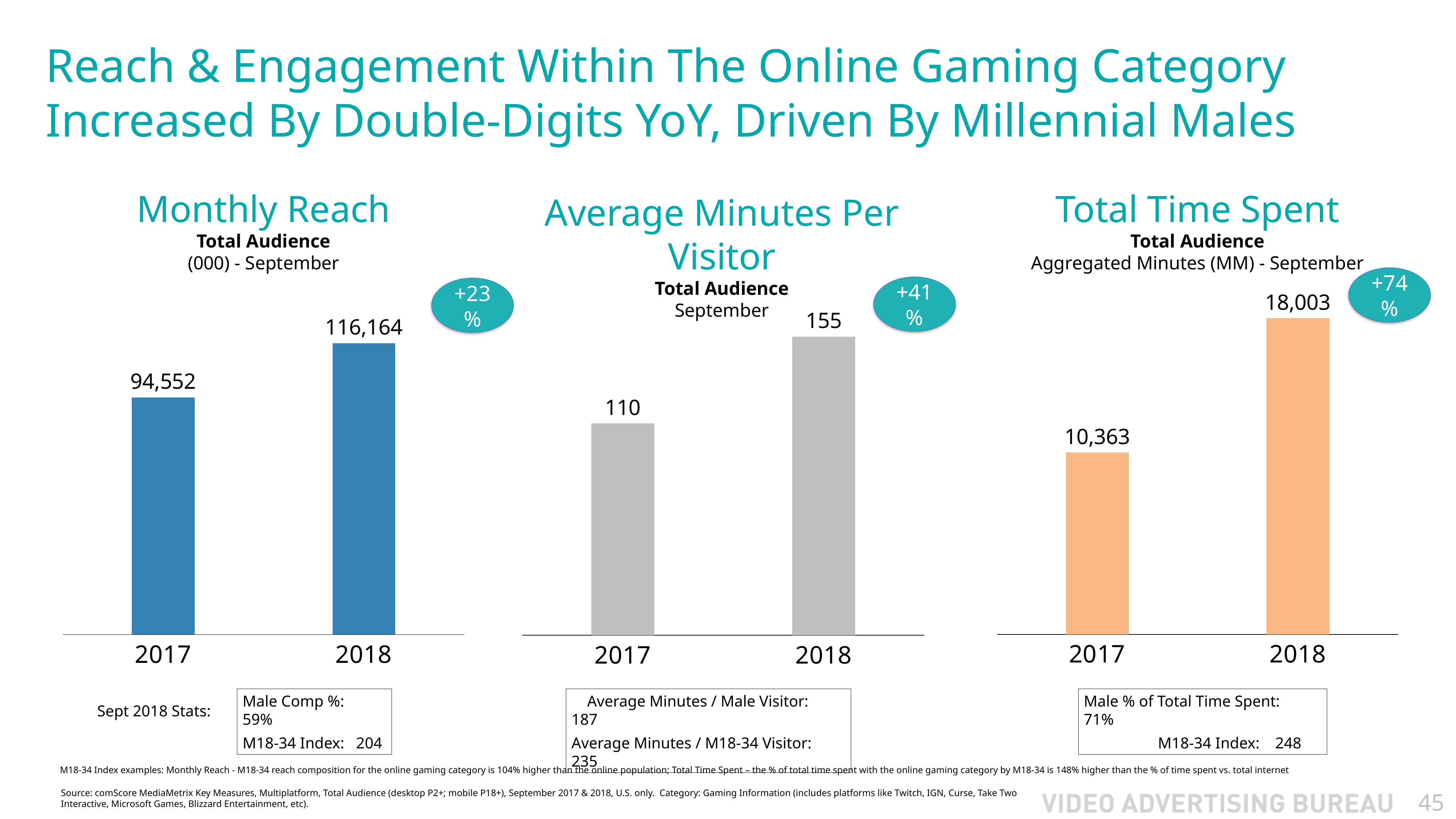
What kind of chart is the Monthly Reach chart? Bar chart In the Total Time Spent chart, what is the difference between the 2018 and 2017 values? 7,640 In the Average Minutes Per Visitor chart, what is the difference between the 2018 and 2017 values? 45 In the Average Minutes Per Visitor chart, do the values rise or fall from 2017 to 2018? Rise In the Total Time Spent chart, which year has the highest value? 2018 In the Monthly Reach chart, what is the value for 2018? 116,164 In the Monthly Reach chart, what is the difference between the 2018 and 2017 values? 21,612 In the Average Minutes Per Visitor chart, which year has the lowest value? 2017 In the Total Time Spent chart, what is the value for 2017? 10,363 In the Monthly Reach chart, what is the value for 2017? 94,552 In the Average Minutes Per Visitor chart, what is the value for 2018? 155 In the Total Time Spent chart, which is larger, the value for 2017 or the value for 2018? 2018